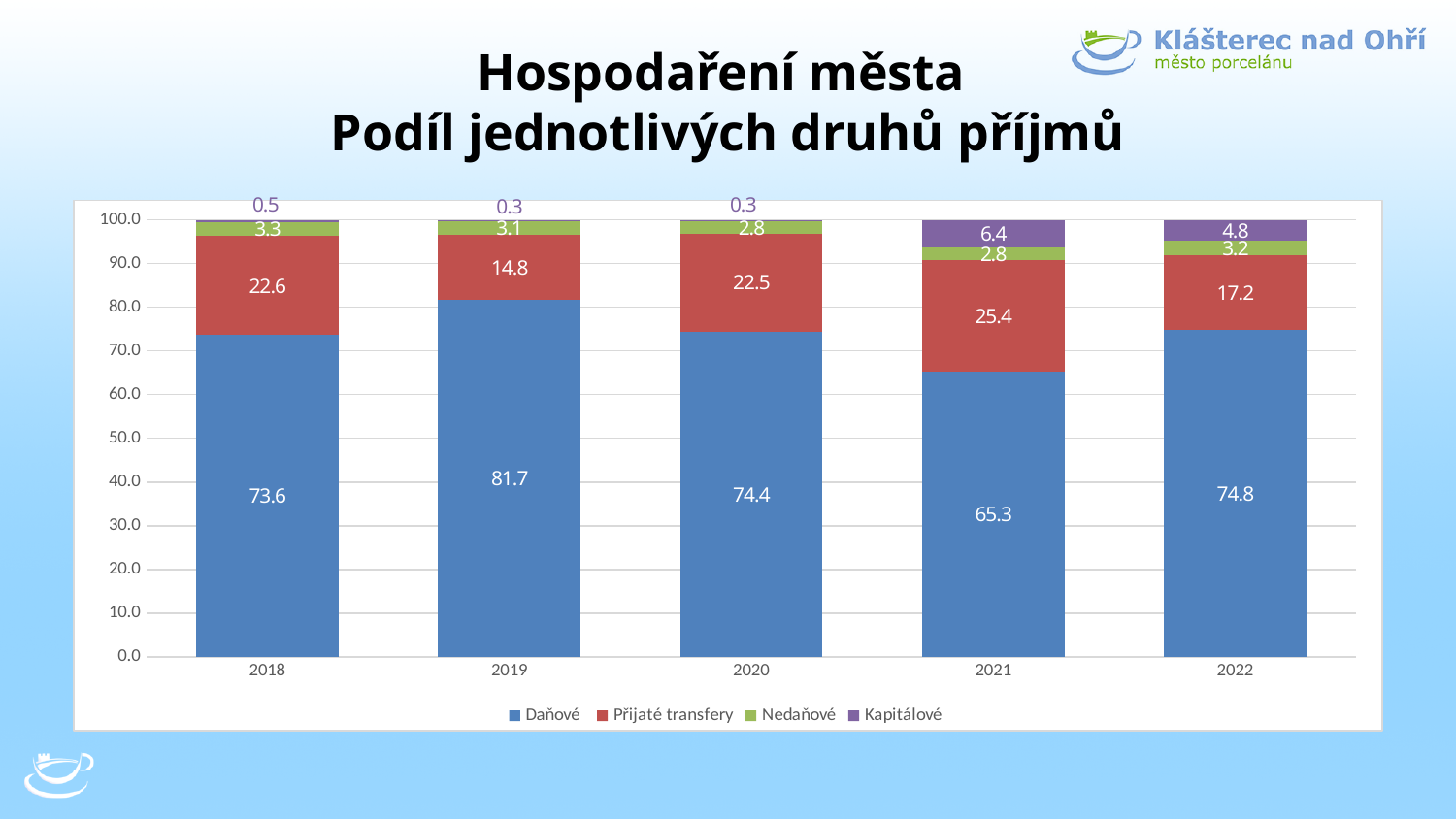
How many years are shown on the x axis? 5 In which year is the Daňové value the highest? 2019 What is the value of Daňové for 2019? 81.7 What is the value of Kapitálové for 2022? 4.8 In which year is the Daňové value the lowest? 2021 How many series does the legend list? 4 Which is larger, the Kapitálové value for 2021 or for 2022? 2021 What is the value of Přijaté transfery for 2021? 25.4 What kind of chart is shown on the slide? Stacked bar chart What is the value of Nedaňové for 2018? 3.3 What is the difference between the Přijaté transfery values for 2021 and 2019? 10.6 What is the total of the stacked bar for 2020? 100.0